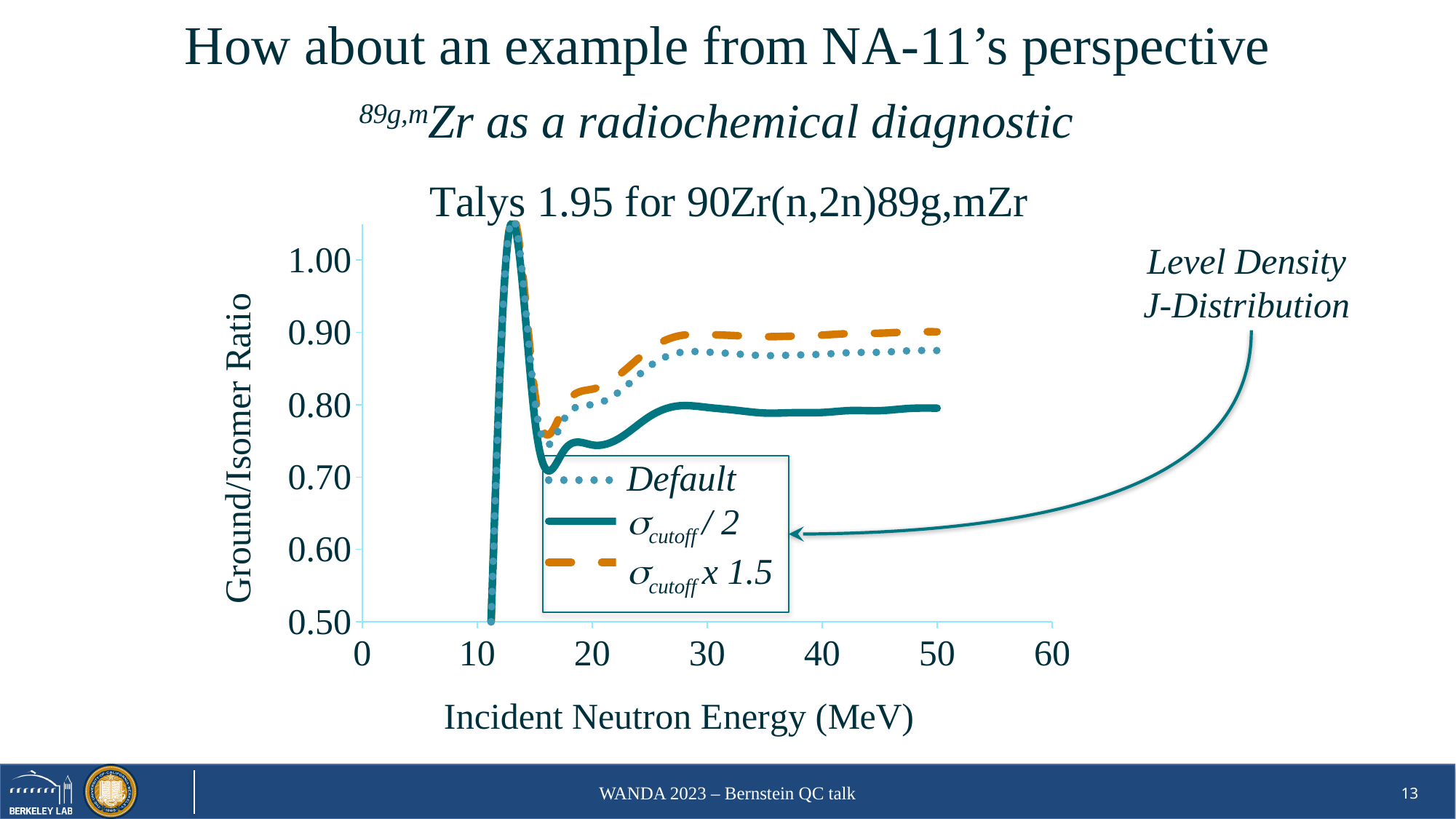
Is the minimum value of the σcutoff / 2 series near 16 MeV greater or less than 0.80? less What is the title of the chart? Talys 1.95 for 90Zr(n,2n)89g,mZr Is the value of the Default series at 50 MeV greater or less than 0.80? greater Which series has the highest Ground/Isomer Ratio at 50 MeV? σcutoff x 1.5 At 50 MeV, is the Default series or the σcutoff / 2 series higher? Default At 40 MeV, is the σcutoff x 1.5 series or the Default series higher? σcutoff x 1.5 What is the label of the x axis? Incident Neutron Energy (MeV) Is the value of the Default series at 50 MeV greater or less than 0.90? less How many series does the legend list? 3 Do the curves rise or fall between about 16 MeV and 30 MeV? rise What kind of chart is shown on the slide? line chart Which series has the lowest Ground/Isomer Ratio at 50 MeV? σcutoff / 2